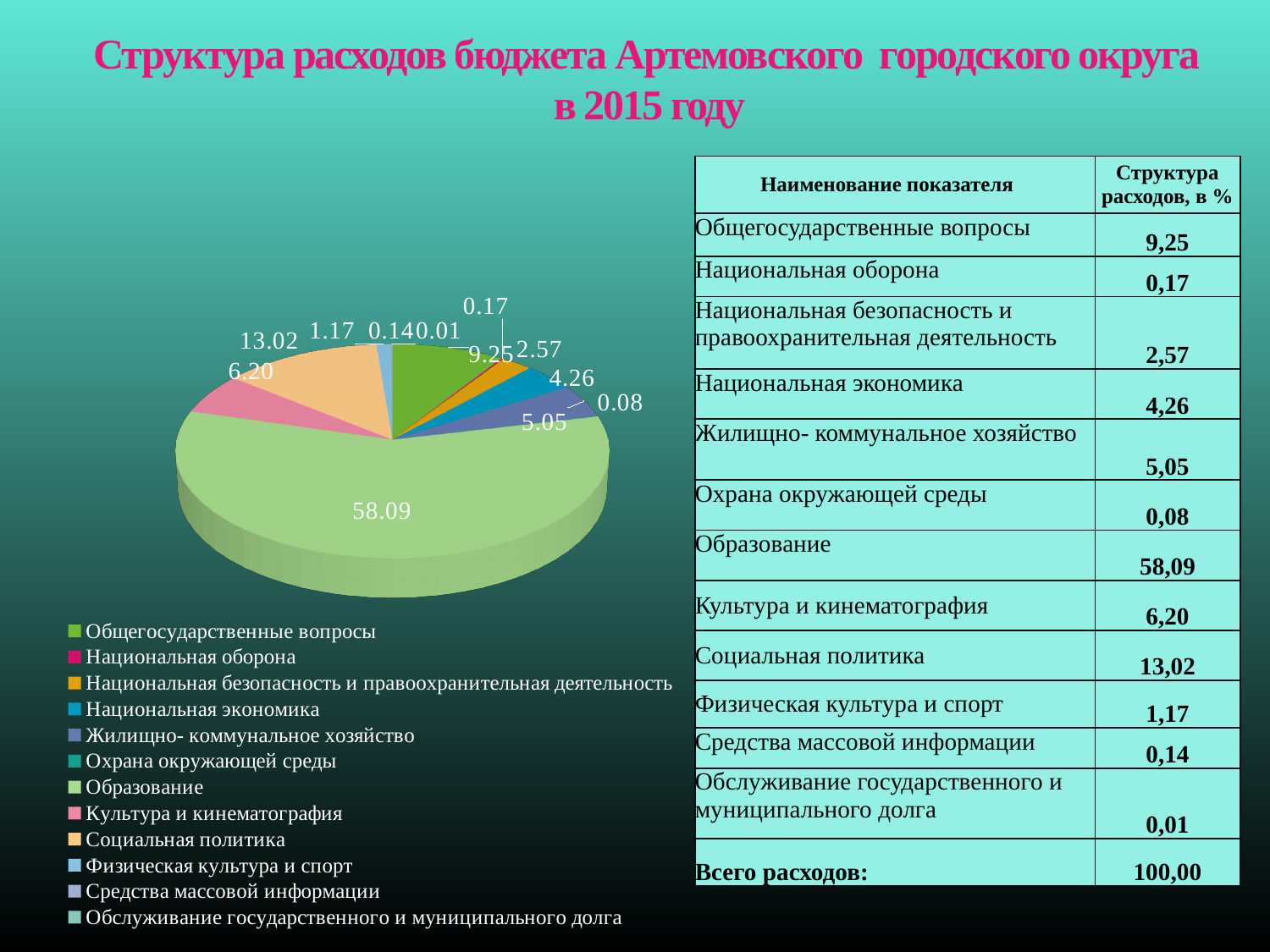
Which is larger in the pie chart: Культура и кинематография or Национальная экономика? Культура и кинематография What is the value shown for Образование in the pie chart? 58.09 What is the difference between the values for Образование and Социальная политика in the pie chart? 45.07 What is the value shown for Общегосударственные вопросы in the pie chart? 9.25 Which category has the largest slice in the pie chart? Образование What is the value shown for Социальная политика in the pie chart? 13.02 What is the title of the slide containing the pie chart? Структура расходов бюджета Артемовского городского округа в 2015 году Which category has the smallest value in the pie chart? Обслуживание государственного и муниципального долга What is the value shown for Жилищно- коммунальное хозяйство in the pie chart? 5.05 What is the difference between the values for Национальная экономика and Национальная безопасность и правоохранительная деятельность in the pie chart? 1.69 What kind of chart is shown on the slide? pie chart How many categories does the legend of the pie chart list? 12